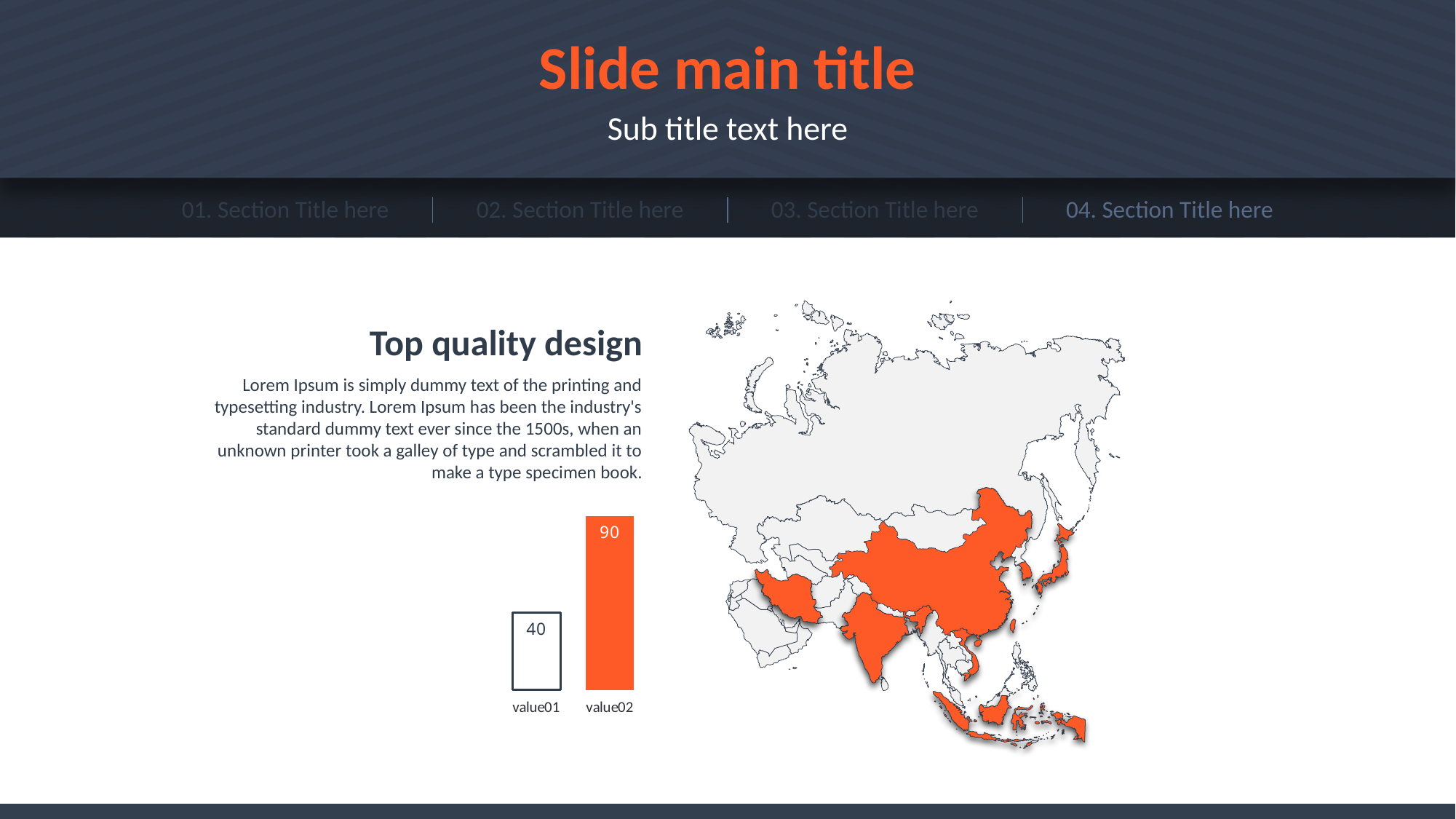
What is the value for value01? 40 What kind of chart is shown on the slide? bar chart What is the value for value02? 90 What is the total of value01 and value02? 130 Which bar is filled in orange? value02 What is the difference between value02 and value01? 50 How many categories are shown in the bar chart? 2 Do the values rise or fall from value01 to value02? rise Which category has the highest value? value02 Which is larger, value01 or value02? value02 Which category has the lowest value? value01 Which bar is drawn as an outline with a white fill? value01